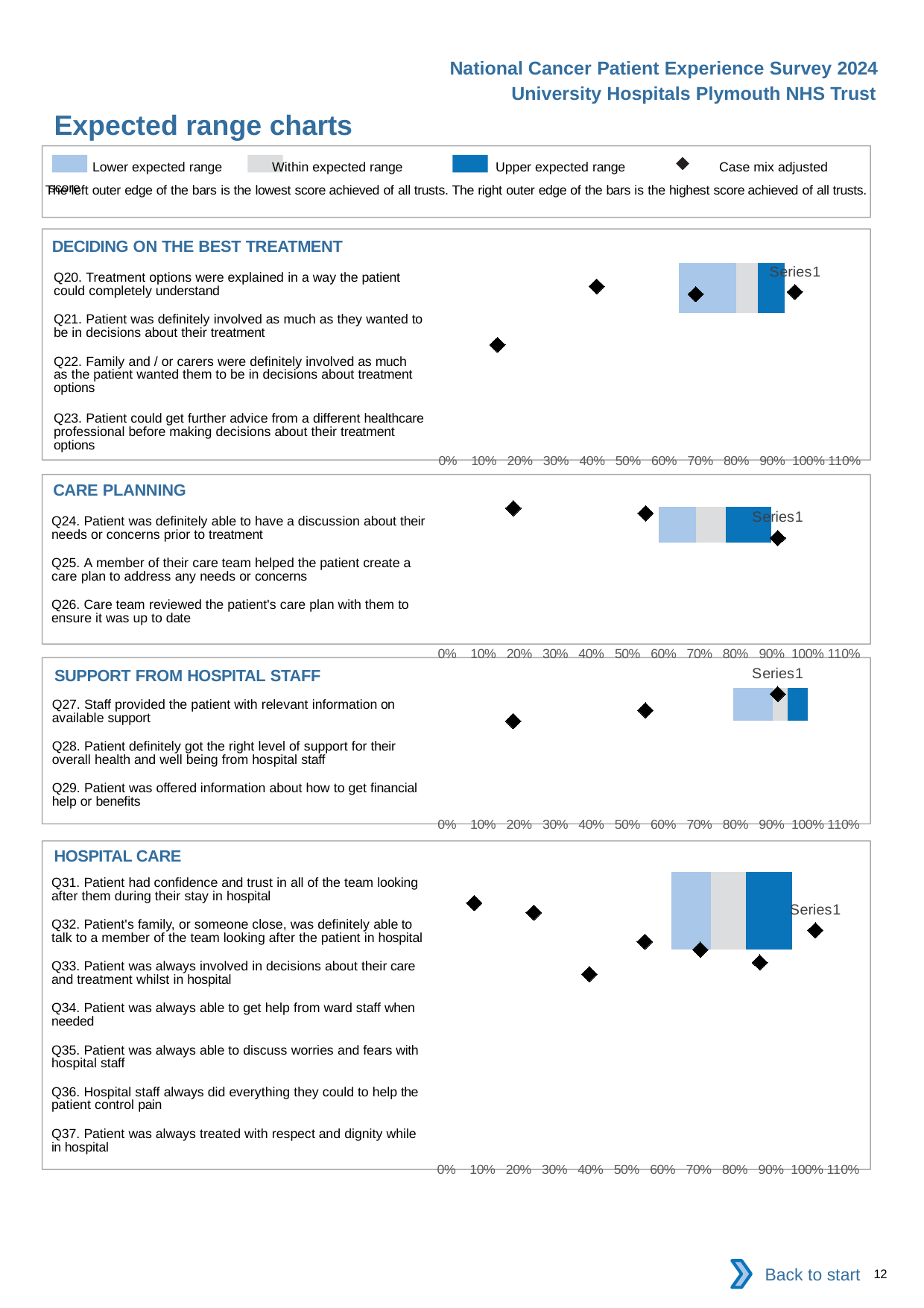
What is the highest percentage tick shown on the x axis of the HOSPITAL CARE chart? 110% In the CARE PLANNING chart, how many questions (categories) are listed? 3 According to the legend, what does the dark blue colour represent? Upper expected range How many entries does the shared legend at the top of the slide list? 4 In the DECIDING ON THE BEST TREATMENT chart, how many questions (categories) are listed? 4 In the SUPPORT FROM HOSPITAL STAFF chart, how many questions (categories) are listed? 3 In the HOSPITAL CARE chart, which question is listed first? Q31. Patient had confidence and trust in all of the team looking after them during their stay in hospital